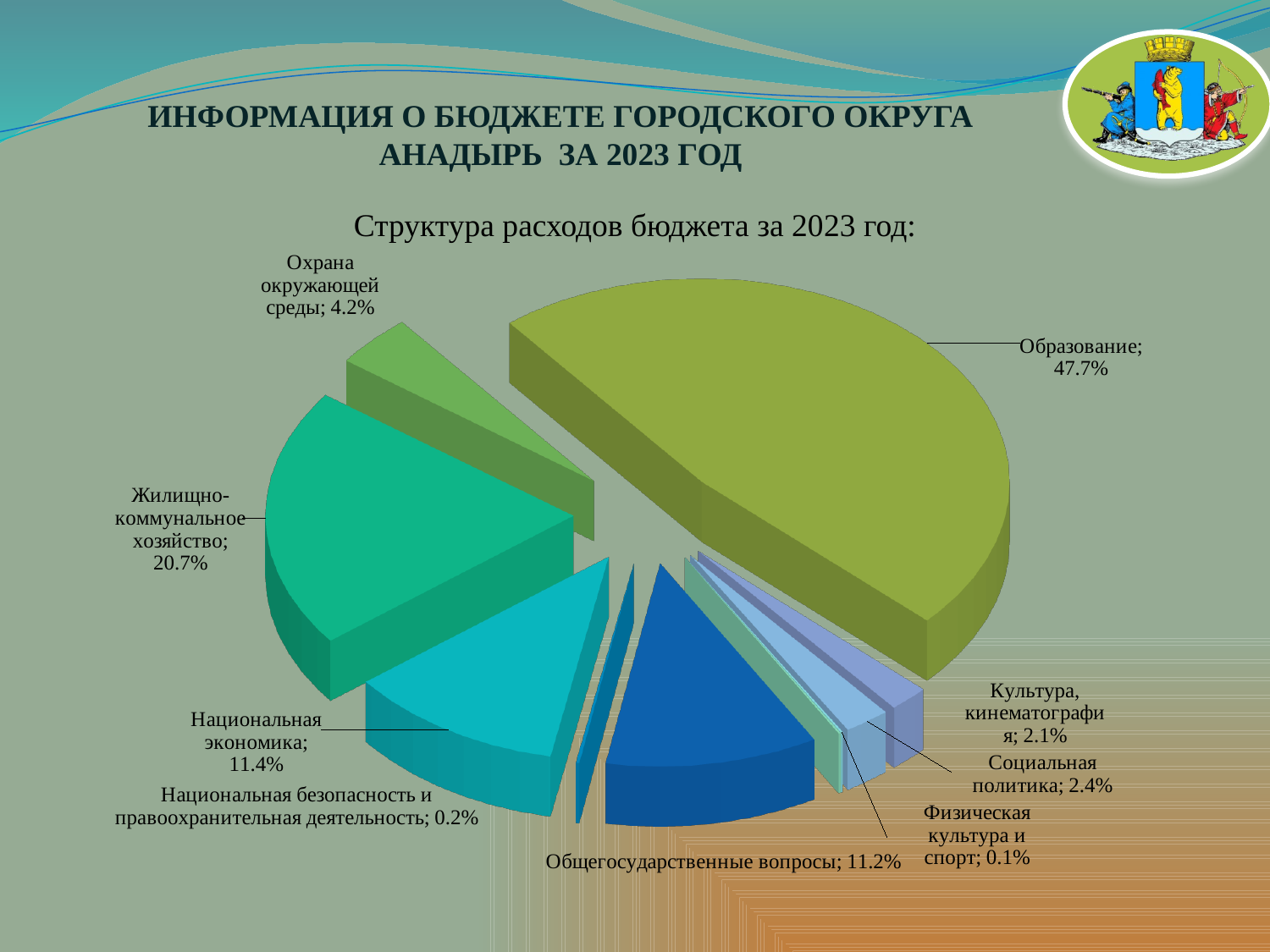
What is the value for Охрана окружающей среды? 4.2% How many categories (slices) does the pie chart have? 10 What is the difference between the shares of Образование and Жилищно-коммунальное хозяйство? 27.0% What is the value shown for Жилищно-коммунальное хозяйство? 20.7% What is the difference between the shares of Социальная политика and Культура, кинематография? 0.3% What share of the budget expenditure goes to Образование? 47.7% Which is larger: Национальная экономика or Общегосударственные вопросы? Национальная экономика What kind of chart is shown on the slide? Pie chart What percentage is labelled for Общегосударственные вопросы? 11.2% What is the title of the chart? Структура расходов бюджета за 2023 год: Which category has the largest share of the pie? Образование